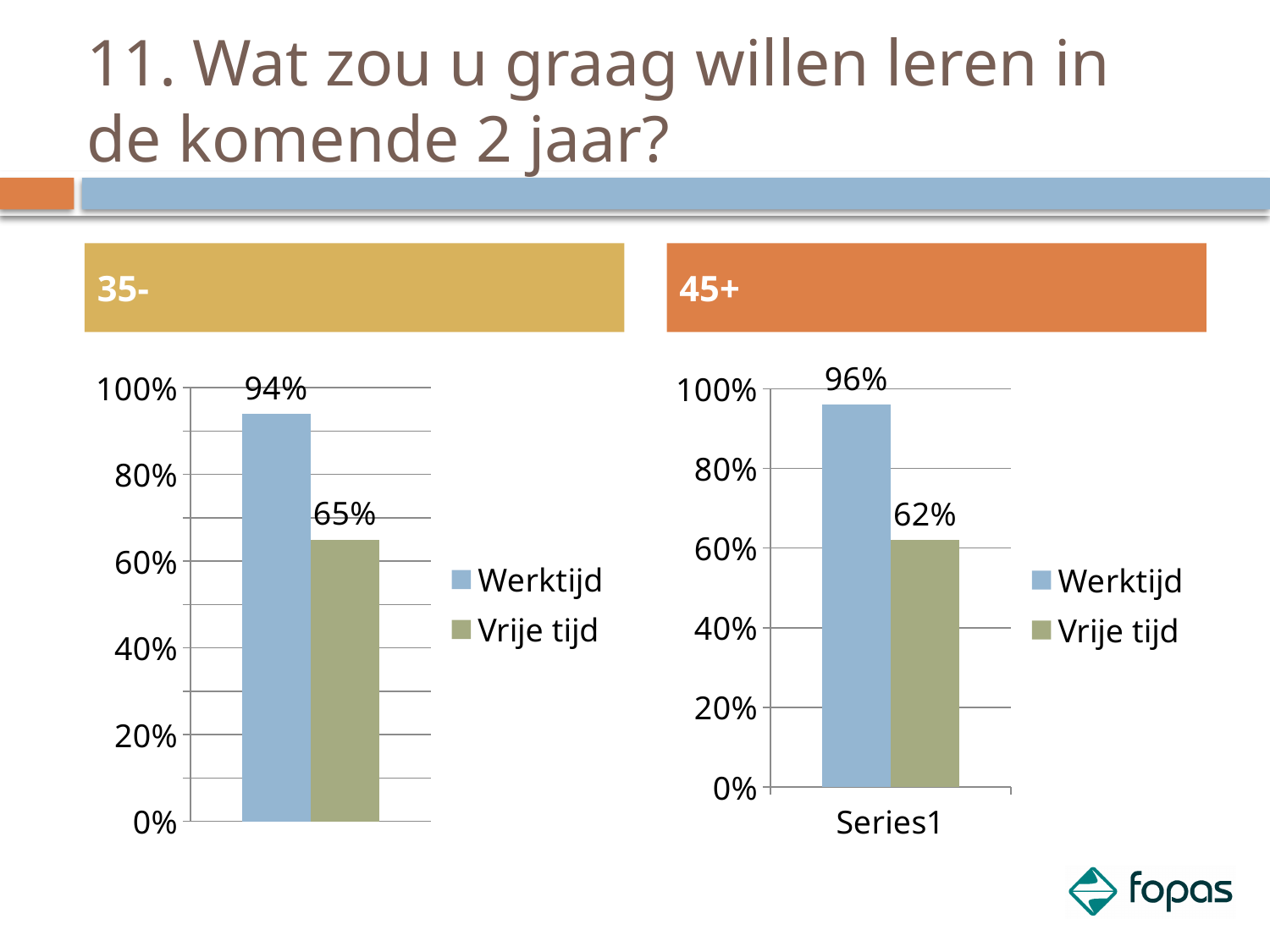
In the 45+ chart, which series has the lowest value? Vrije tijd In the 35- chart, what is the difference between Werktijd and Vrije tijd? 29% In the 35- chart, what is the value for Vrije tijd? 65% What kind of chart is the 35- chart? Bar chart In the 45+ chart, what is the value for Vrije tijd? 62% In the 45+ chart, what is the value for Werktijd? 96% In the 35- chart, what is the value for Werktijd? 94% In the 45+ chart, what is the category label shown on the x axis? Series1 In the 35- chart, which series has the highest value? Werktijd In the 45+ chart, what is the difference between Werktijd and Vrije tijd? 34% Which is larger: Vrije tijd in the 35- chart or Vrije tijd in the 45+ chart? Vrije tijd in the 35- chart How many series does the legend of the 45+ chart list? 2